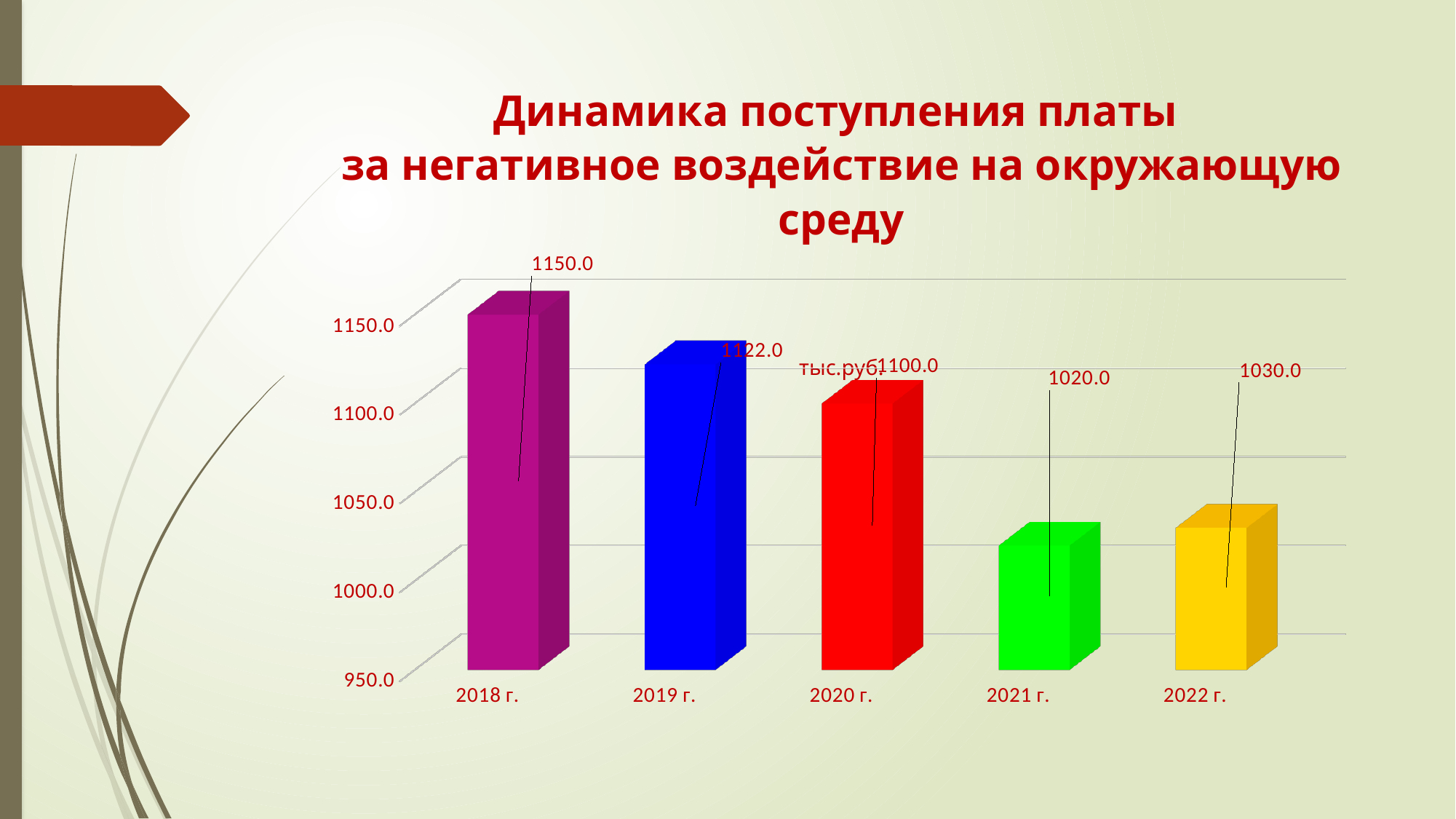
What is the value for 2018 г.? 1150.0 What is the value for 2022 г.? 1030.0 Is the value for 2020 г. greater or less than 1050.0? greater How many years are shown on the x axis? 5 Do the values generally rise or fall from 2018 г. to 2021 г.? fall What kind of chart is shown on the slide? bar chart Which is larger, the value for 2021 г. or the value for 2022 г.? 2022 г. What is the difference between the values for 2018 г. and 2020 г.? 50.0 Which year has the highest value? 2018 г. What is the value for 2021 г.? 1020.0 Which year has the lowest value? 2021 г. What is the value for 2019 г.? 1122.0